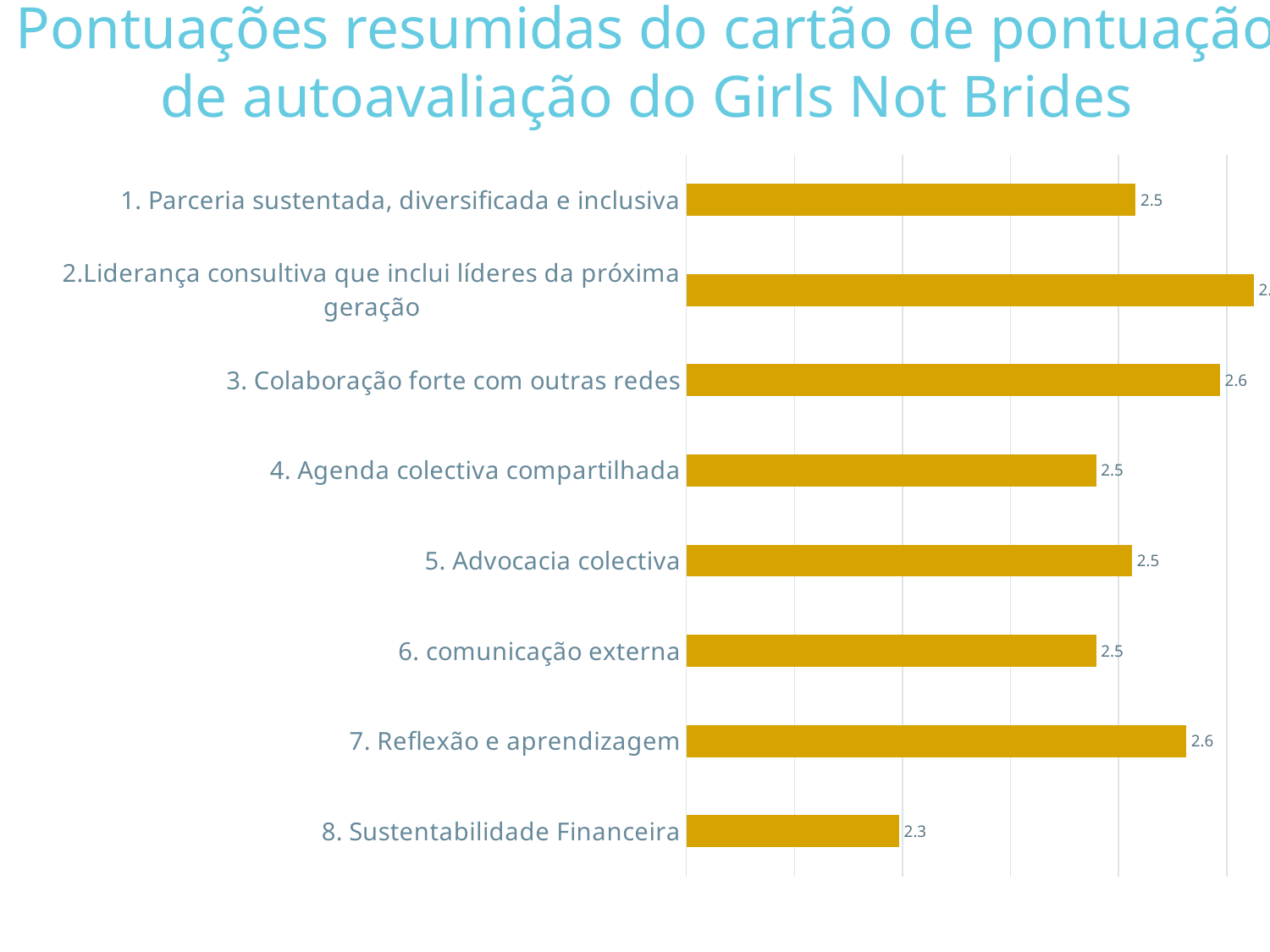
What is the value for "3. Colaboração forte com outras redes"? 2.6 Which category has the longest bar? 2.Liderança consultiva que inclui líderes da próxima geração What is the value for "7. Reflexão e aprendizagem"? 2.6 What is the value for "5. Advocacia colectiva"? 2.5 How many categories are plotted in the chart? 8 What is the value for "1. Parceria sustentada, diversificada e inclusiva"? 2.5 What is the difference between the values for "3. Colaboração forte com outras redes" and "8. Sustentabilidade Financeira"? 0.3 Which is larger, the value for "7. Reflexão e aprendizagem" or for "8. Sustentabilidade Financeira"? 7. Reflexão e aprendizagem Which category has the lowest value? 8. Sustentabilidade Financeira What type of chart is shown on the slide? bar chart What colour are the bars in the chart? gold/yellow What is the value for "8. Sustentabilidade Financeira"? 2.3